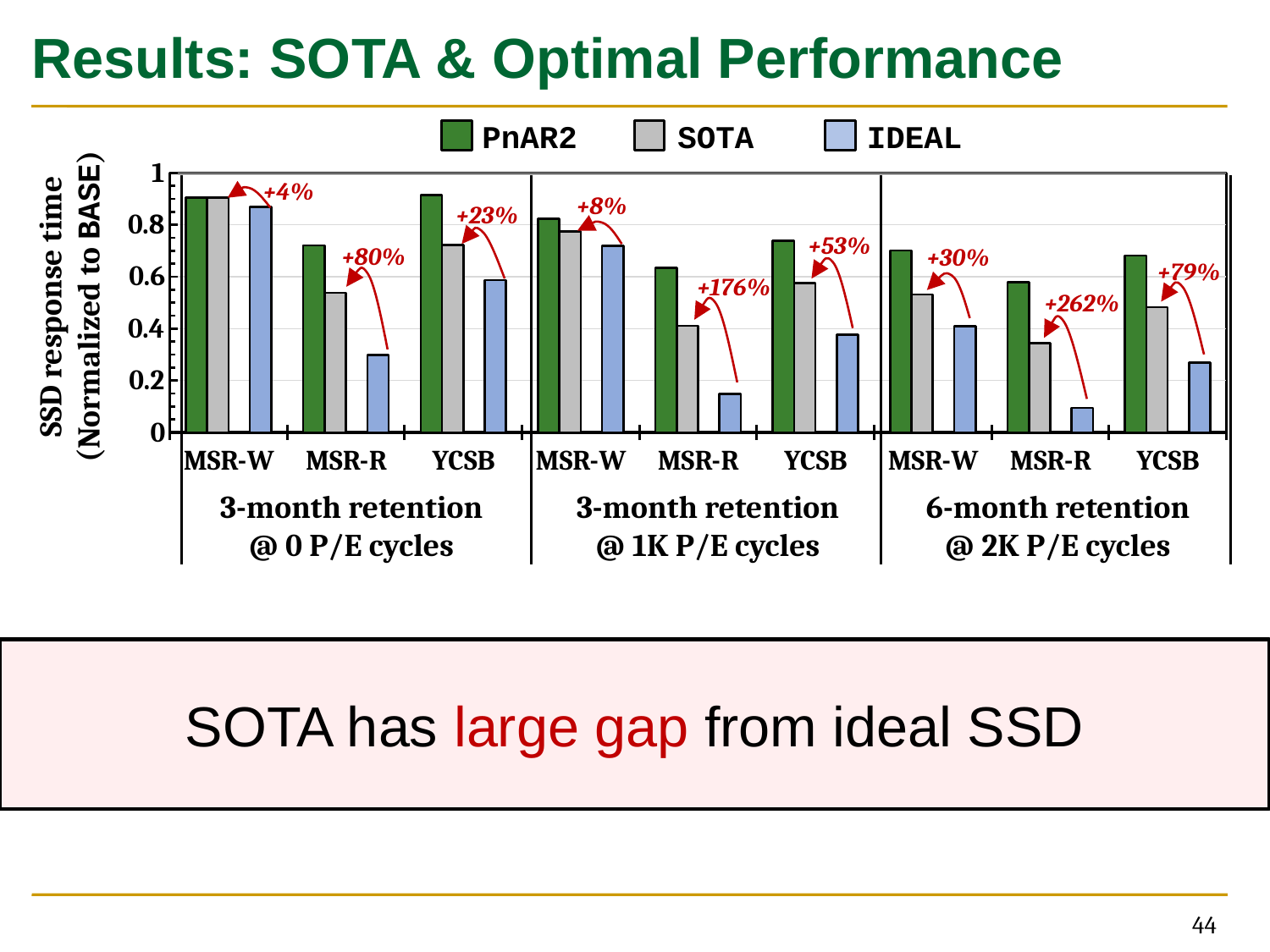
Which workload and retention group has the largest annotated percentage gap? MSR-R, 6-month retention @ 2K P/E cycles (+262%) What percentage gap is annotated for MSR-W under 3-month retention @ 0 P/E cycles? +4% What percentage gap is annotated for MSR-R under 6-month retention @ 2K P/E cycles? +262% For MSR-R under 6-month retention @ 2K P/E cycles, which is larger: the PnAR2 bar or the IDEAL bar? PnAR2 What are the three series named in the legend? PnAR2, SOTA, IDEAL How many retention/P-E-cycle groups are shown along the x axis? 3 Is the IDEAL value for MSR-R under 3-month retention @ 1K P/E cycles greater or less than 0.2? less What is the smallest annotated percentage gap on the chart? +4% How many series does the legend list? 3 What kind of chart is shown on the slide? bar chart What percentage gap is annotated for MSR-R under 3-month retention @ 1K P/E cycles? +176% Is the PnAR2 value for MSR-W under 3-month retention @ 0 P/E cycles greater or less than 0.8? greater